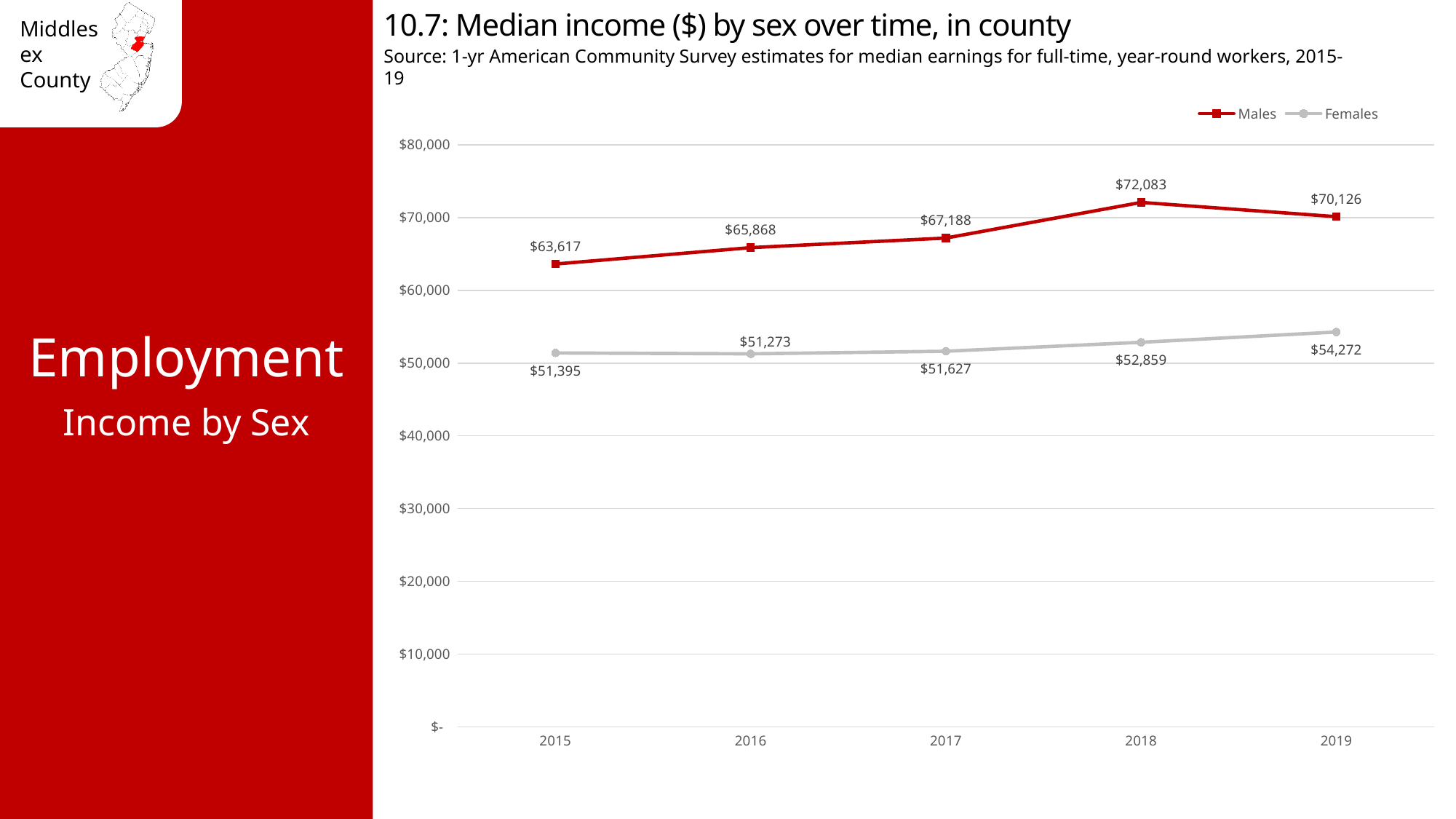
Does the median income for Females rise or fall from 2016 to 2019? rise What kind of chart is shown on the slide? line chart How many years are shown on the x axis? 5 How many series does the legend list? 2 What was the median income for Males in 2018? $72,083 In which year was the median income for Males highest? 2018 What was the median income for Females in 2015? $51,395 In which year was the median income for Females lowest? 2016 What is the difference between the Males and Females median income in 2019? $15,854 Is the median income for Females in 2018 greater or less than $60,000? less Which series had the higher median income in 2017, Males or Females? Males What was the median income for Males in 2016? $65,868